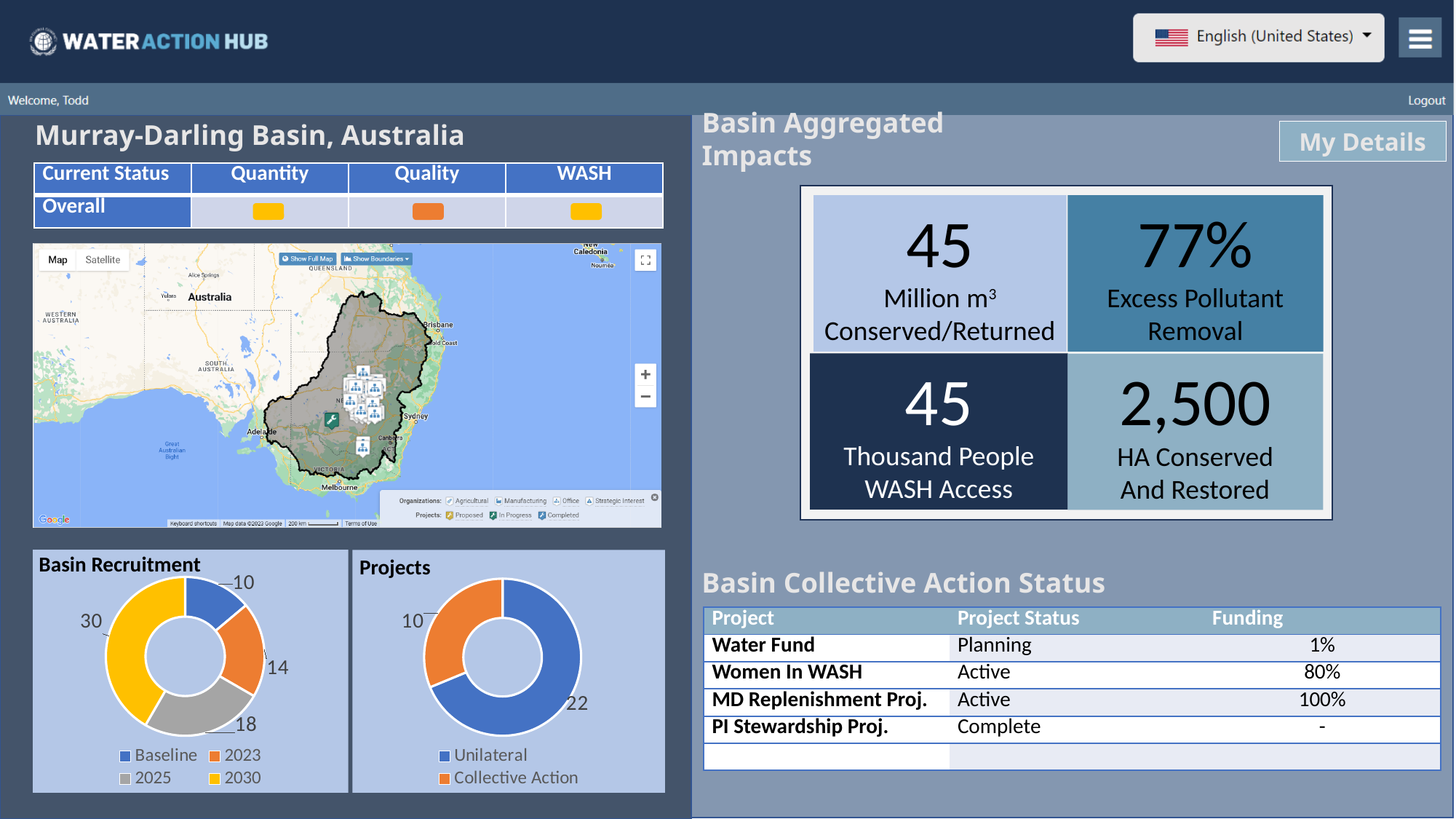
In the Basin Recruitment chart, how many categories are shown? 4 In the Basin Recruitment chart, what is the value for 2030? 30 In the Basin Recruitment chart, what is the total of all the segments? 72 In the Basin Recruitment chart, which category has the highest value? 2030 In the Projects chart, what is the value for Unilateral? 22 What kind of chart is the Projects chart? Doughnut chart In the Basin Recruitment chart, which category has the lowest value? Baseline In the Projects chart, which is larger, Unilateral or Collective Action? Unilateral In the Basin Recruitment chart, what is the difference between the 2025 and 2023 values? 4 In the Projects chart, what is the difference between the Unilateral and Collective Action values? 12 In the Projects chart, what is the value for Collective Action? 10 In the Basin Recruitment chart, what is the value for Baseline? 10